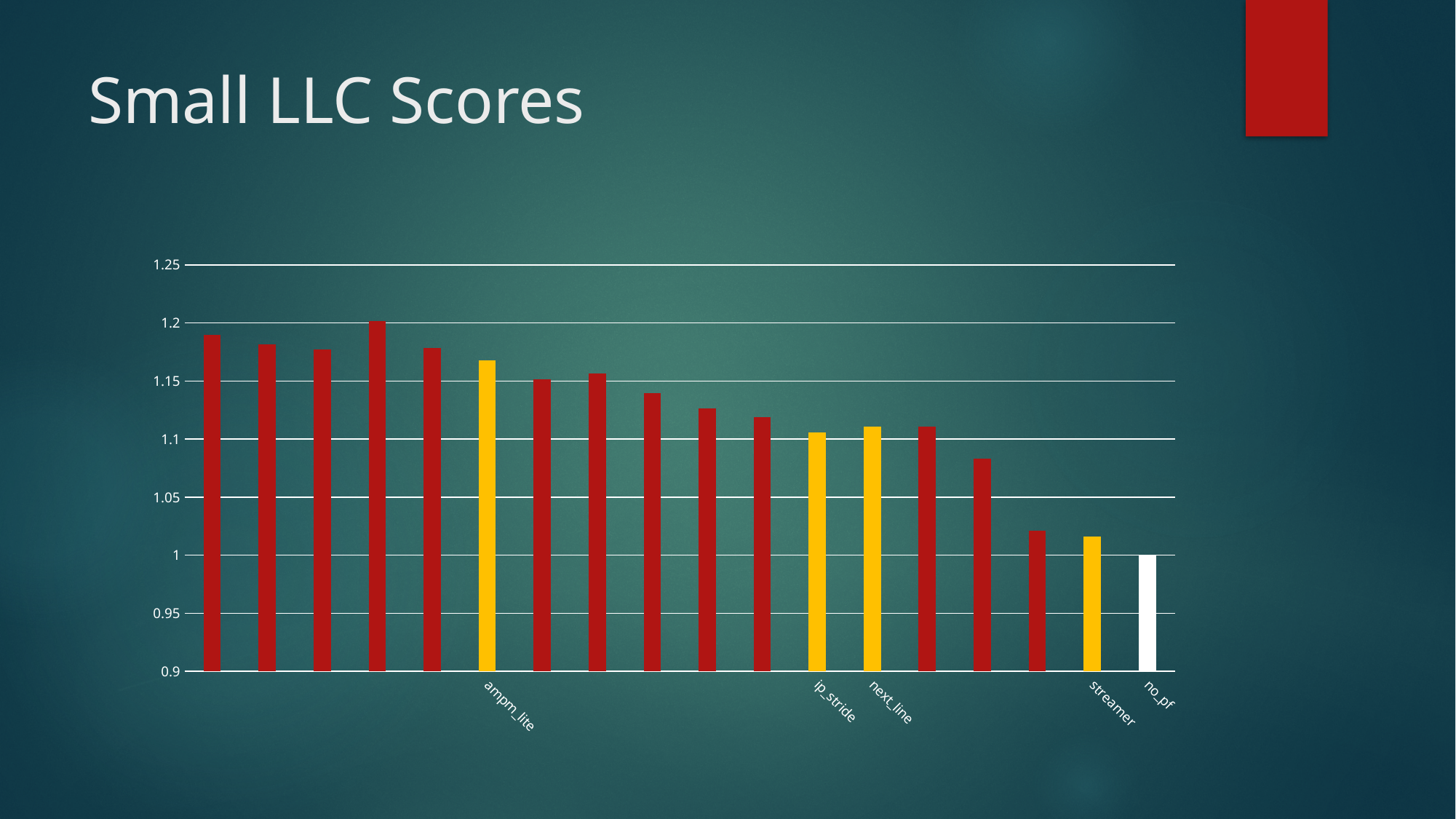
Which has the larger value, ip_stride or streamer? ip_stride What is the value for no_pf? 1 Is the value for streamer greater or less than 1.05? less Which has the larger value, ampm_lite or next_line? ampm_lite What kind of chart is shown on the slide? bar chart Is the value for ampm_lite greater or less than 1.15? greater Which bar has the lowest value in the chart? no_pf Is the value for ampm_lite greater or less than 1.2? less How many bars are plotted in the chart? 18 What is the title of the chart? Small LLC Scores Do the values generally rise or fall from left to right across the chart? fall